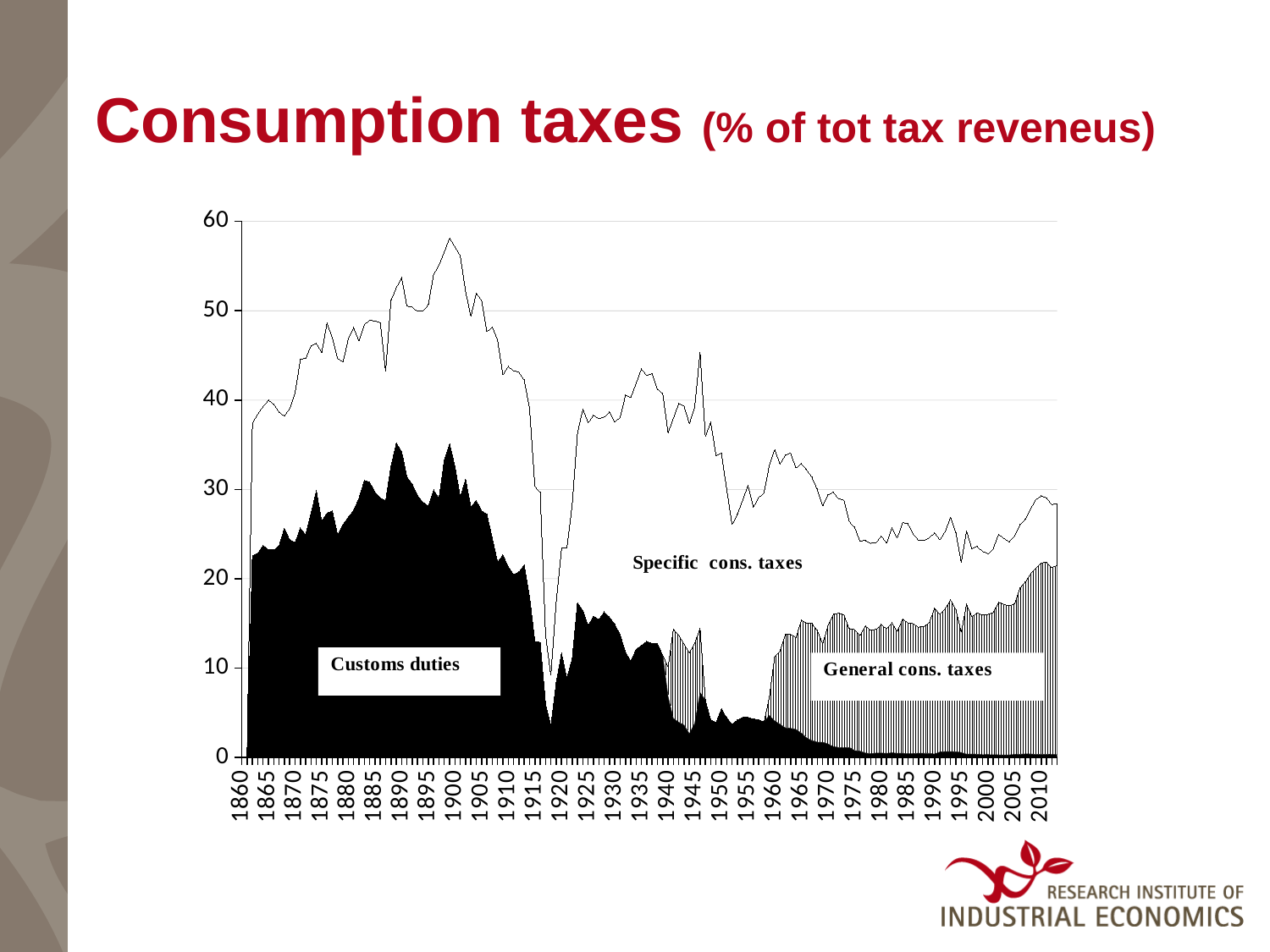
Does the value for General cons. taxes rise or fall between 1960 and 2010? rise Is the value for Customs duties around 2010 greater or less than 10? less Is the total of consumption taxes around 1920 greater or less than 30? less Is the total of consumption taxes around 1900 greater or less than 50? greater What is the title of the chart on the slide? Consumption taxes (% of tot tax reveneus) How many tax series are labelled in the chart? 3 What is the highest value shown on the vertical axis? 60 Which is larger around 1890: Customs duties or Specific cons. taxes? Customs duties Which series is the largest around 2010: Customs duties, Specific cons. taxes or General cons. taxes? General cons. taxes What kind of chart is shown on the slide? Area chart